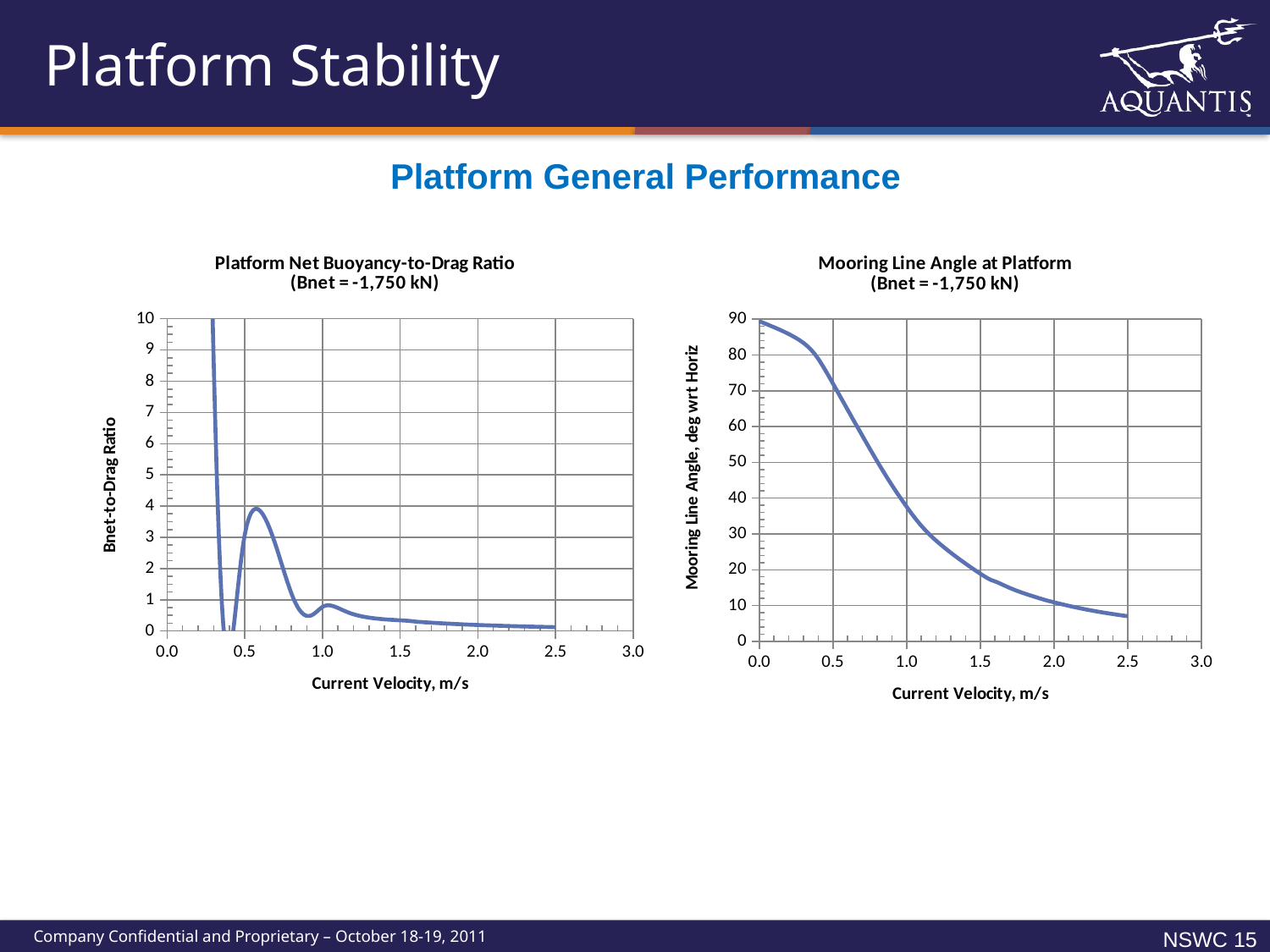
In the right chart, 'Mooring Line Angle at Platform', is the mooring line angle at 1.0 m/s larger or smaller than at 0.5 m/s? smaller In the right chart, 'Mooring Line Angle at Platform', is the mooring line angle at a current velocity of 2.5 m/s greater or less than 10? less What is the x-axis label of the right chart, 'Mooring Line Angle at Platform'? Current Velocity, m/s What kind of chart is the right chart, 'Mooring Line Angle at Platform'? line chart In the right chart, 'Mooring Line Angle at Platform', is the mooring line angle at a current velocity of 0.0 m/s greater or less than 80? greater In the right chart, 'Mooring Line Angle at Platform', does the mooring line angle rise or fall as current velocity increases? fall In the left chart, 'Platform Net Buoyancy-to-Drag Ratio', is the ratio at a current velocity of 2.0 m/s greater or less than 1? less In the left chart, 'Platform Net Buoyancy-to-Drag Ratio', does the ratio rise or fall as current velocity increases from 1.5 to 2.5 m/s? fall What kind of chart is the left chart, 'Platform Net Buoyancy-to-Drag Ratio'? line chart What Bnet value is stated in the title of the left chart, 'Platform Net Buoyancy-to-Drag Ratio'? -1,750 kN